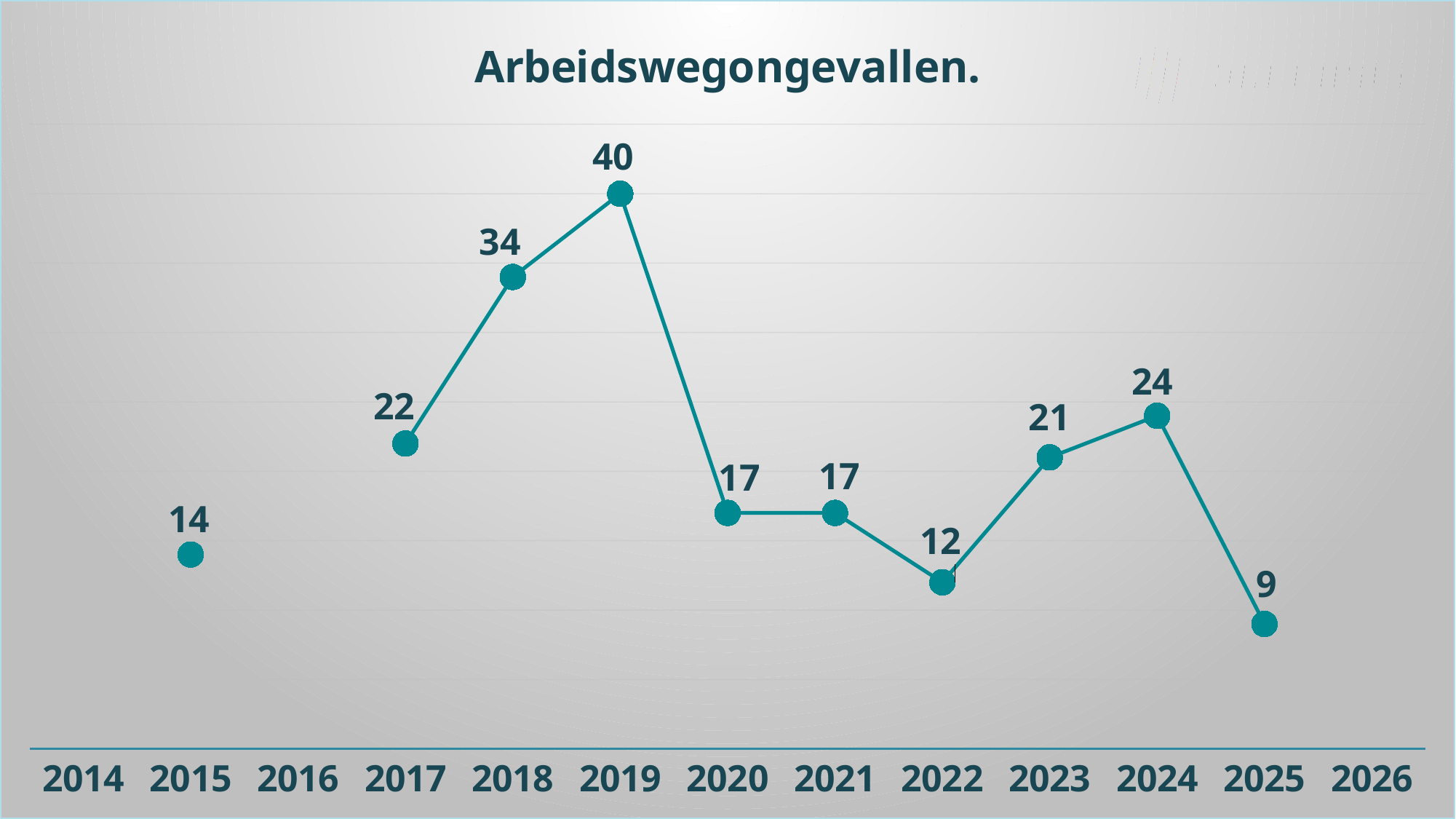
What is the title of the chart? Arbeidswegongevallen. How many data points are plotted on the line? 10 Which year has the lowest value? 2025 What is the difference between the values for 2019 and 2018? 6 What is the value for 2019? 40 What is the value for 2025? 9 Do the values rise or fall from 2017 to 2019? rise Which year has the highest value? 2019 What is the value for 2022? 12 What is the difference between the values for 2024 and 2025? 15 What kind of chart is shown? line chart